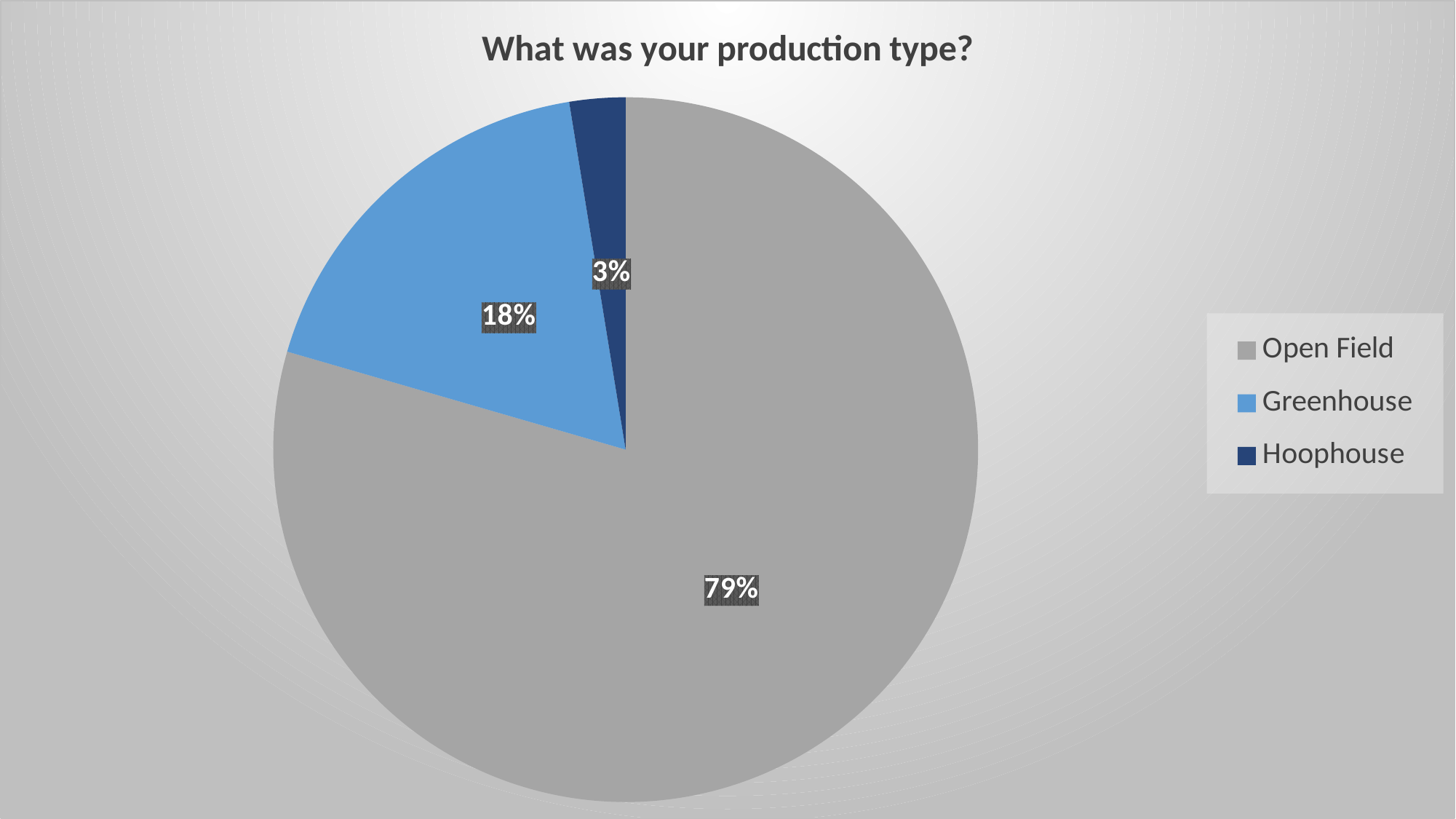
What is the title of the chart? What was your production type? What share of the pie is Greenhouse? 18% What kind of chart is shown on the slide? Pie chart Which production type has the smallest share? Hoophouse How many categories does the pie chart show? 3 What is the difference in percentage points between Greenhouse and Hoophouse? 15 Which is larger, the Greenhouse share or the Hoophouse share? Greenhouse Which category is shown in light blue in the legend? Greenhouse What is the difference in percentage points between Open Field and Greenhouse? 61 Which production type has the largest share? Open Field What share of the pie is Hoophouse? 3% What share of the pie is Open Field? 79%